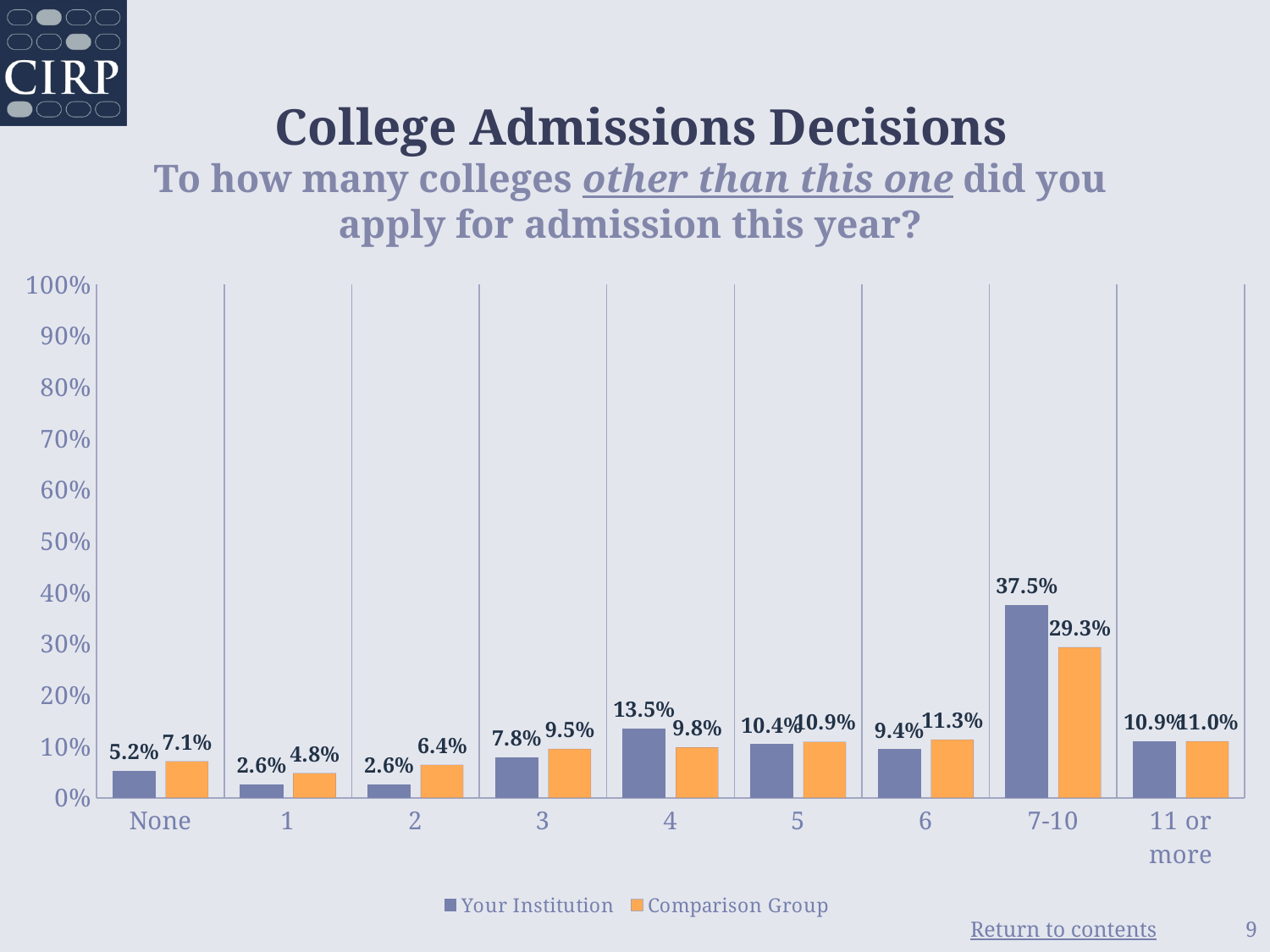
Is the value for Your Institution in the 7-10 category greater or less than 30%? greater How many series does the legend list? 2 In the 7-10 category, what is the difference between Your Institution and the Comparison Group? 8.2 percentage points How many categories are shown on the x axis? 9 What is the value for Your Institution in the 3 category? 7.8% What are the two series named in the legend? Your Institution and Comparison Group What kind of chart is shown on the slide? bar chart Which category has the lowest value for the Comparison Group? 1 What is the value for the Comparison Group in the 2 category? 6.4% What is the value for Your Institution in the 7-10 category? 37.5% In the 4 category, which series has the larger value, Your Institution or the Comparison Group? Your Institution Which category has the highest value for the Comparison Group? 7-10